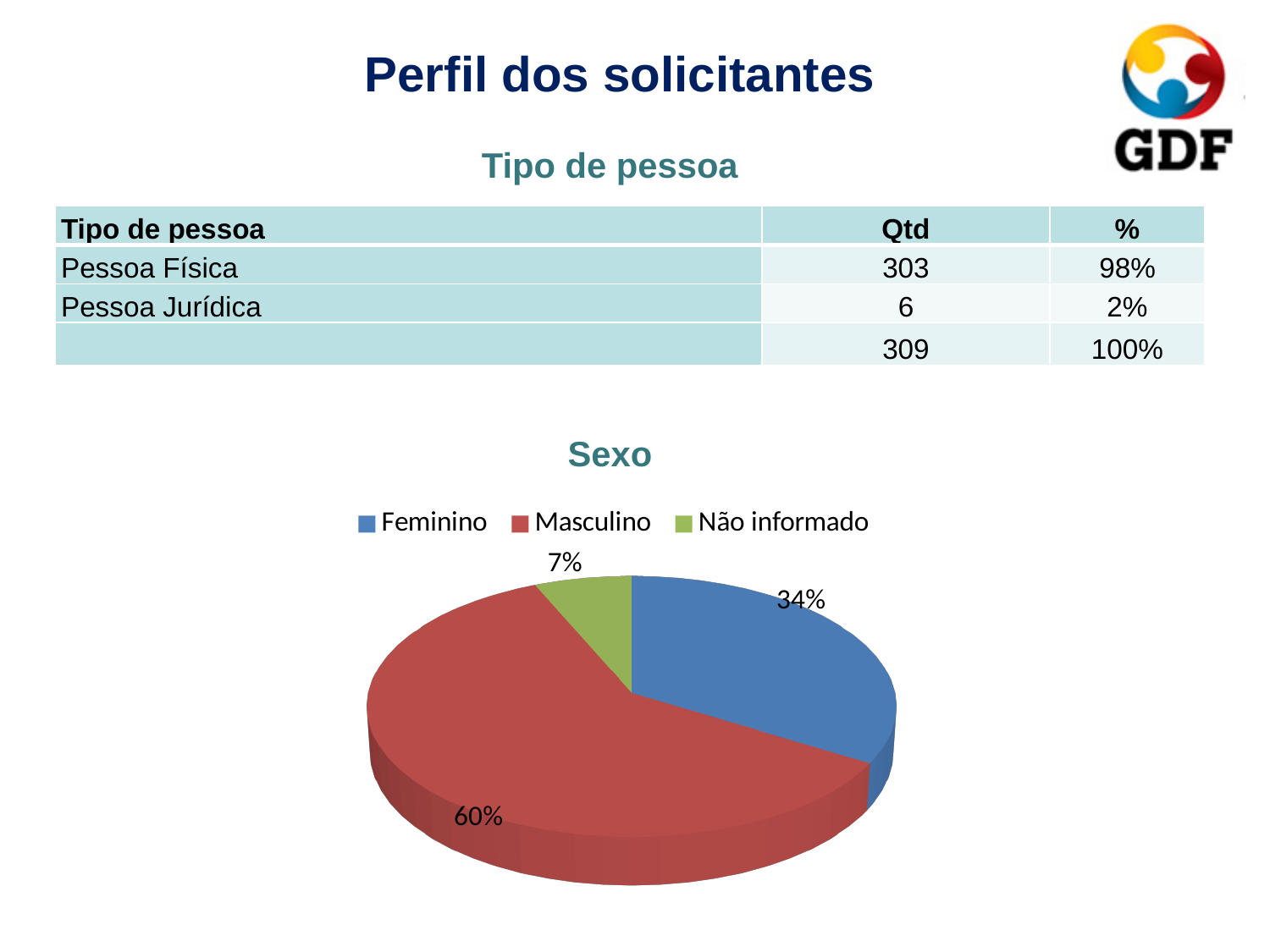
In the "Sexo" pie chart, what is the difference in percentage points between Masculino and Feminino? 26 In the "Sexo" pie chart, what share is labelled for Masculino? 60% In the "Sexo" pie chart, what colour is the Masculino slice? red In the "Sexo" pie chart, which category has the smallest slice? Não informado In the "Sexo" pie chart, which category has the largest slice? Masculino In the "Sexo" pie chart, what share is labelled for Não informado? 7% In the "Sexo" pie chart, what share is labelled for Feminino? 34% In the "Sexo" pie chart, which is larger, Feminino or Não informado? Feminino What kind of chart is the "Sexo" chart? pie chart How many entries does the legend of the "Sexo" pie chart list? 3 How many slices does the "Sexo" pie chart have? 3 What is the title of the pie chart on the slide? Sexo